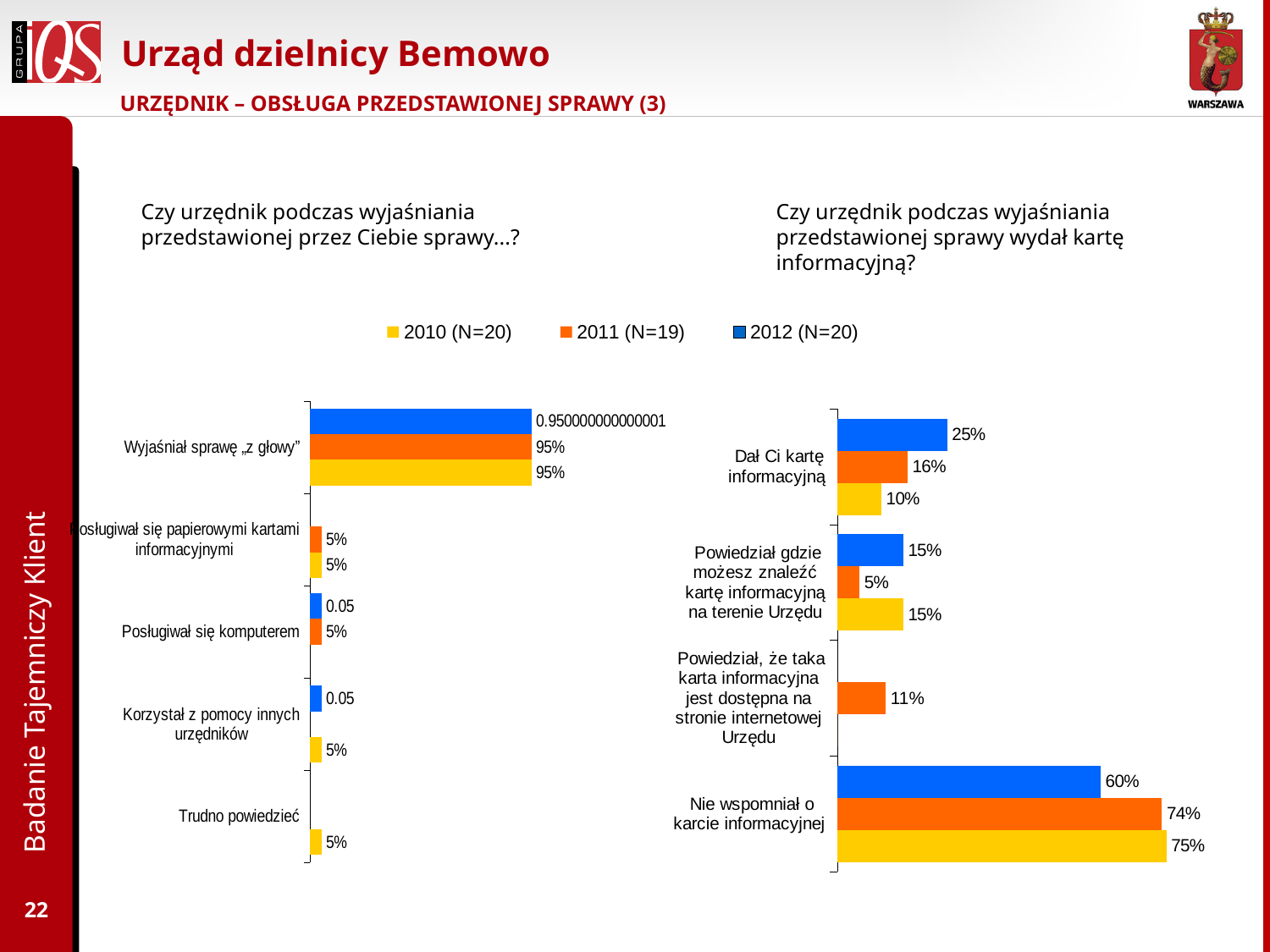
In the right chart, which category has the highest 2010 (N=20) value? Nie wspomniał o karcie informacyjnej In the right chart, which is larger for "Dał Ci kartę informacyjną": the 2011 value or the 2012 value? 2012 (N=20) In the right chart, what is the difference between the 2010 and 2012 values for "Nie wspomniał o karcie informacyjnej"? 15% In the right chart ("Czy urzędnik podczas wyjaśniania przedstawionej sprawy wydał kartę informacyjną?"), what is the 2012 (N=20) value for "Dał Ci kartę informacyjną"? 25% In the right chart, what is the 2010 (N=20) value for "Powiedział gdzie możesz znaleźć kartę informacyjną na terenie Urzędu"? 15% How many series does the legend list? 3 In the right chart, what is the 2011 (N=19) value for "Nie wspomniał o karcie informacyjnej"? 74% What type of chart is the right chart? Bar chart Which colour represents the 2011 (N=19) series in the legend? Orange How many categories are shown in the left chart? 5 In the right chart, which year has the lowest value for "Dał Ci kartę informacyjną"? 2010 (N=20) In the left chart ("Czy urzędnik podczas wyjaśniania przedstawionej przez Ciebie sprawy...?"), what is the 2011 (N=19) value for "Wyjaśniał sprawę „z głowy”"? 95%